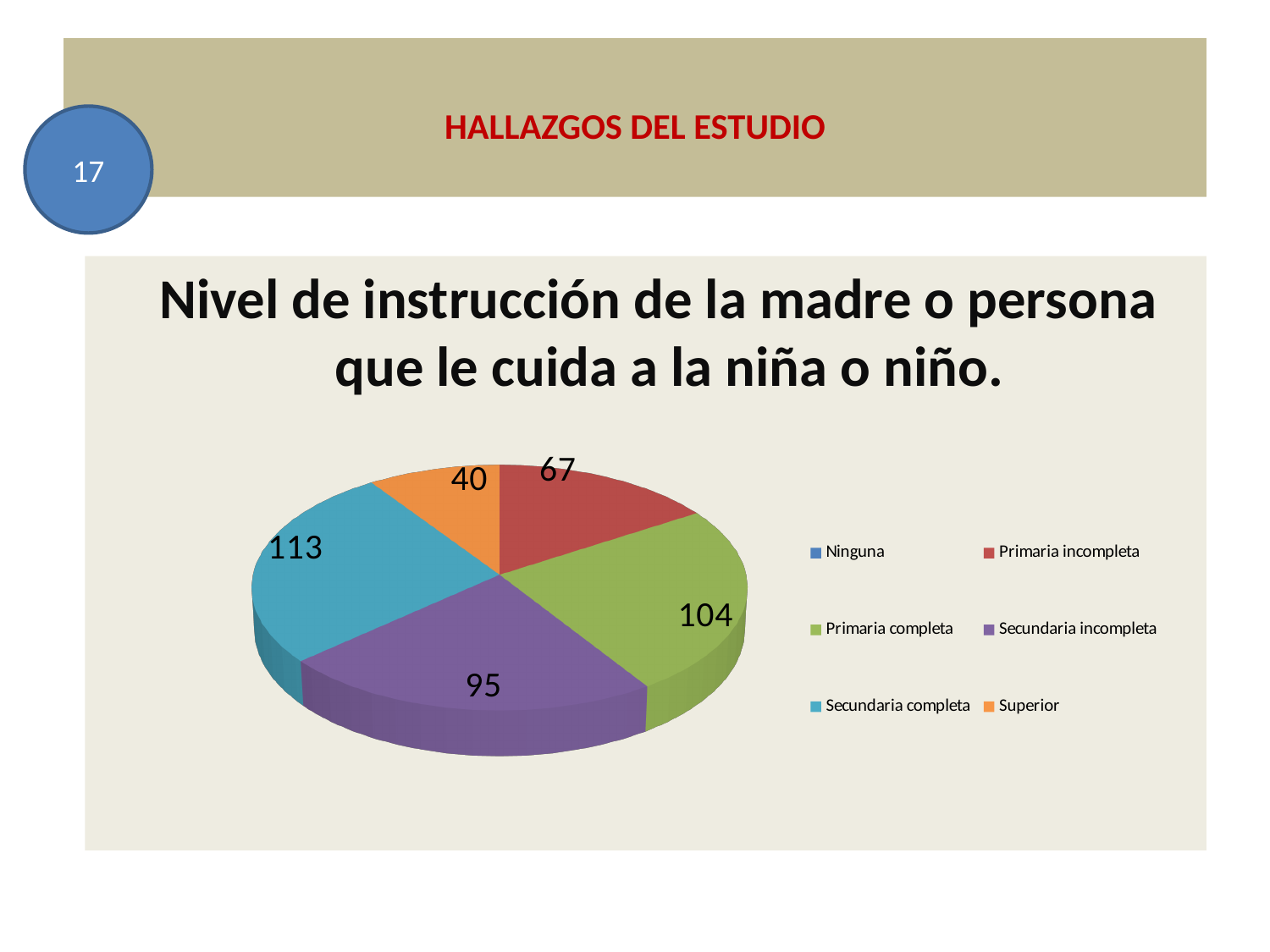
What is the value for Secundaria completa? 113 How many categories does the legend list? 6 What is the value for Secundaria incompleta? 95 What is the title of the chart? Nivel de instrucción de la madre o persona que le cuida a la niña o niño. What is the value for Primaria incompleta? 67 Which is larger, Primaria completa or Secundaria incompleta? Primaria completa Which of the labelled slices has the smallest value? Superior Which category has the largest slice in the pie chart? Secundaria completa What is the value for Primaria completa? 104 What is the difference between the values for Secundaria completa and Superior? 73 What type of chart is shown on the slide? pie chart What is the value for Superior? 40